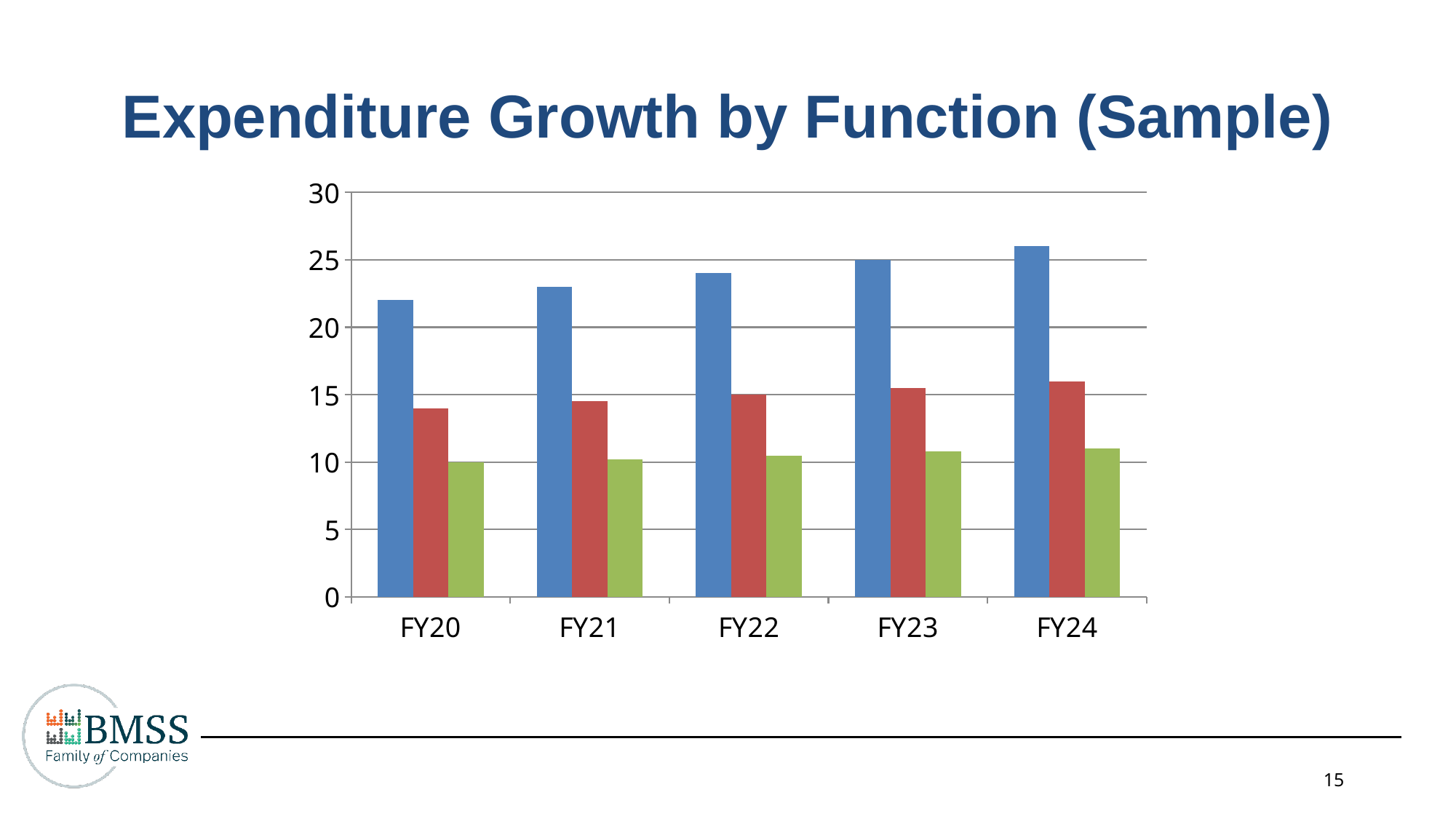
In which fiscal year is the blue bar highest? FY24 Which is larger in FY21, the blue bar or the red bar? the blue bar Is the value of the red bar for FY20 greater or less than 15? less What is the value of the red bar for FY22? 15 What kind of chart is shown on the slide? bar chart What is the value of the blue bar for FY23? 25 What is the value of the green bar for FY20? 10 Do the blue bars rise or fall from FY20 to FY24? rise How many fiscal years are shown on the x axis? 5 In which fiscal year is the red bar lowest? FY20 Is the value of the blue bar for FY24 greater or less than 25? greater What is the title of the chart? Expenditure Growth by Function (Sample)